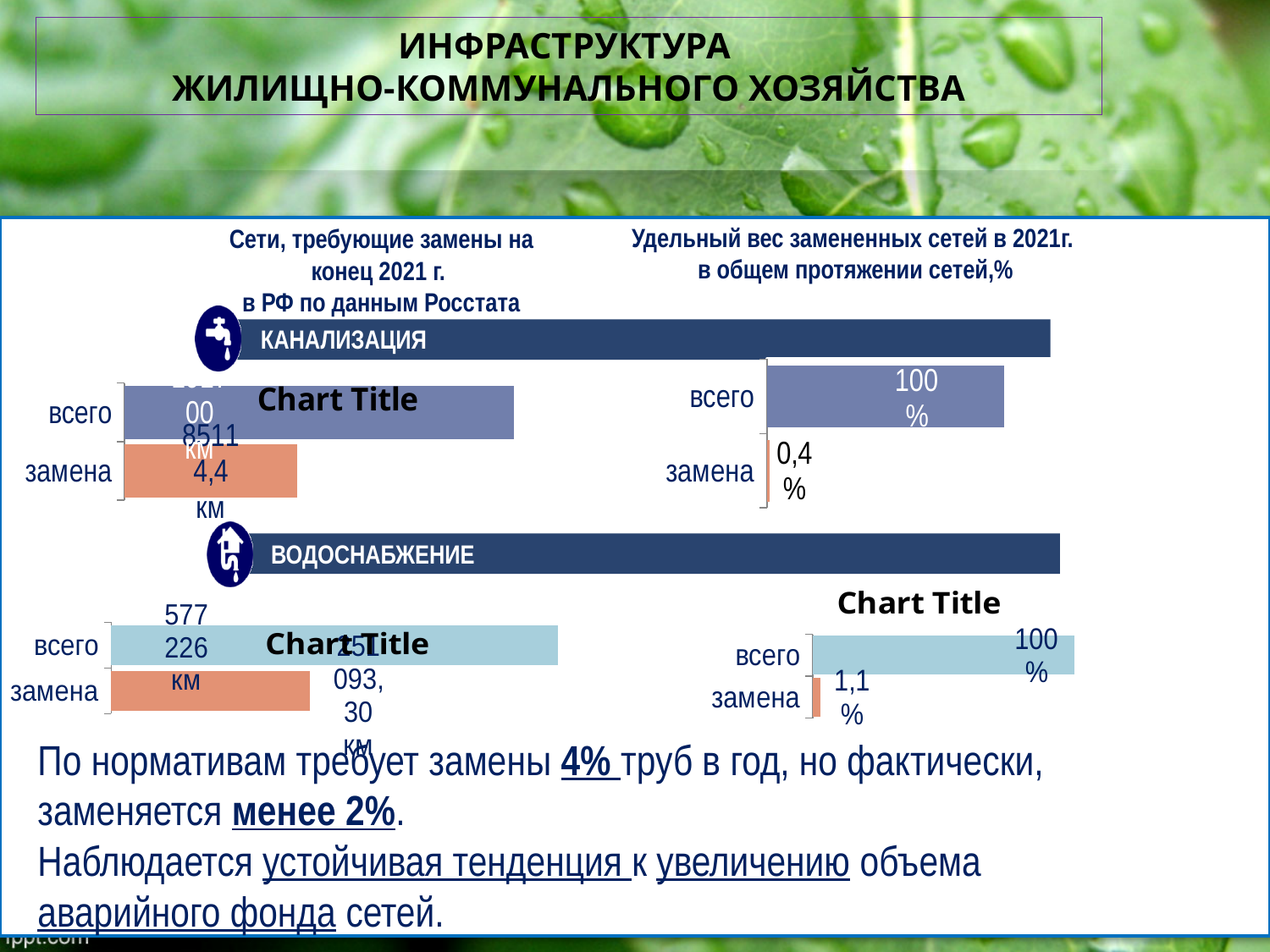
What type of chart is used for the sewerage (КАНАЛИЗАЦИЯ) chart on the left? bar chart In the water supply (ВОДОСНАБЖЕНИЕ) chart on the right showing the share of replaced networks in 2021, what is the value for 'замена'? 1,1 % What is the title printed above the right-hand charts on the slide? Удельный вес замененных сетей в 2021г. в общем протяжении сетей,% In the sewerage (КАНАЛИЗАЦИЯ) chart on the right showing the share of replaced networks in 2021, what is the value for 'всего'? 100 % In the water supply (ВОДОСНАБЖЕНИЕ) chart on the right, what is the difference between the 'всего' and 'замена' values? 98,9 % In the sewerage (КАНАЛИЗАЦИЯ) chart on the right showing the share of replaced networks in 2021, what is the value for 'замена'? 0,4 % In the water supply (ВОДОСНАБЖЕНИЕ) chart on the right, which category has the highest value? всего How many categories are shown in the water supply (ВОДОСНАБЖЕНИЕ) chart on the right? 2 In the water supply (ВОДОСНАБЖЕНИЕ) chart on the right showing the share of replaced networks in 2021, what is the value for 'всего'? 100 % Which is larger: the 'замена' share in the sewerage chart on the right or the 'замена' share in the water supply chart on the right? water supply (1,1 %) In the sewerage (КАНАЛИЗАЦИЯ) chart on the right, which category has the lowest value? замена In the sewerage (КАНАЛИЗАЦИЯ) chart on the right, what is the difference between the 'всего' and 'замена' values? 99,6 %